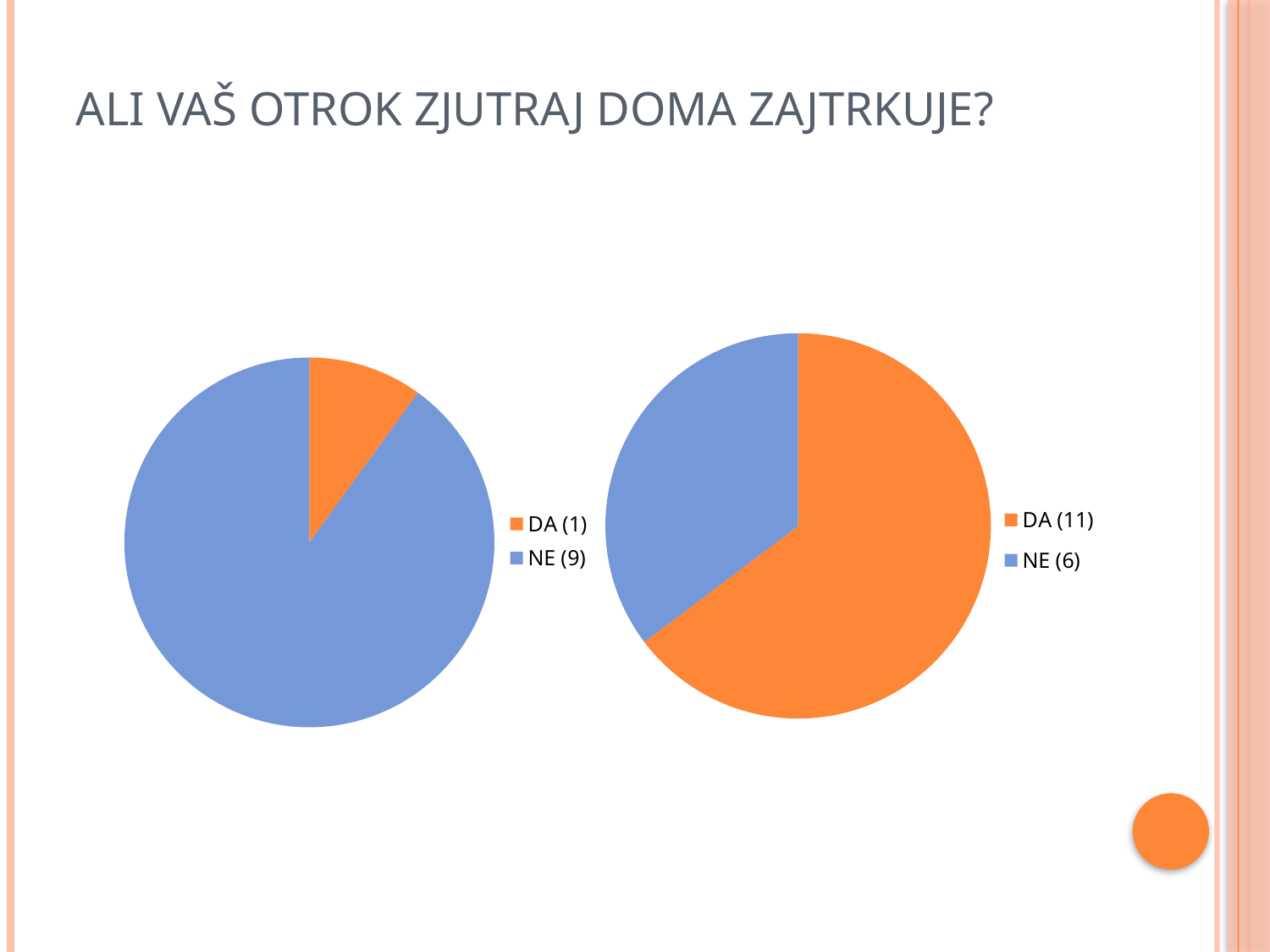
What type of chart is shown on the left of the slide? pie chart In the right pie chart, what is the value for NE? 6 In the left pie chart, what share of the total does DA represent? 10% In the left pie chart, which category is the largest? NE In the right pie chart, which is larger, DA or NE? DA In the right pie chart, which category is the smallest? NE How many entries does the legend of the right pie chart list? 2 In the right pie chart, what is the difference between DA and NE? 5 In the left pie chart, what is the value for DA? 1 In the right pie chart, what is the value for DA? 11 In the left pie chart, what is the value for NE? 9 In the left pie chart, what is the difference between NE and DA? 8